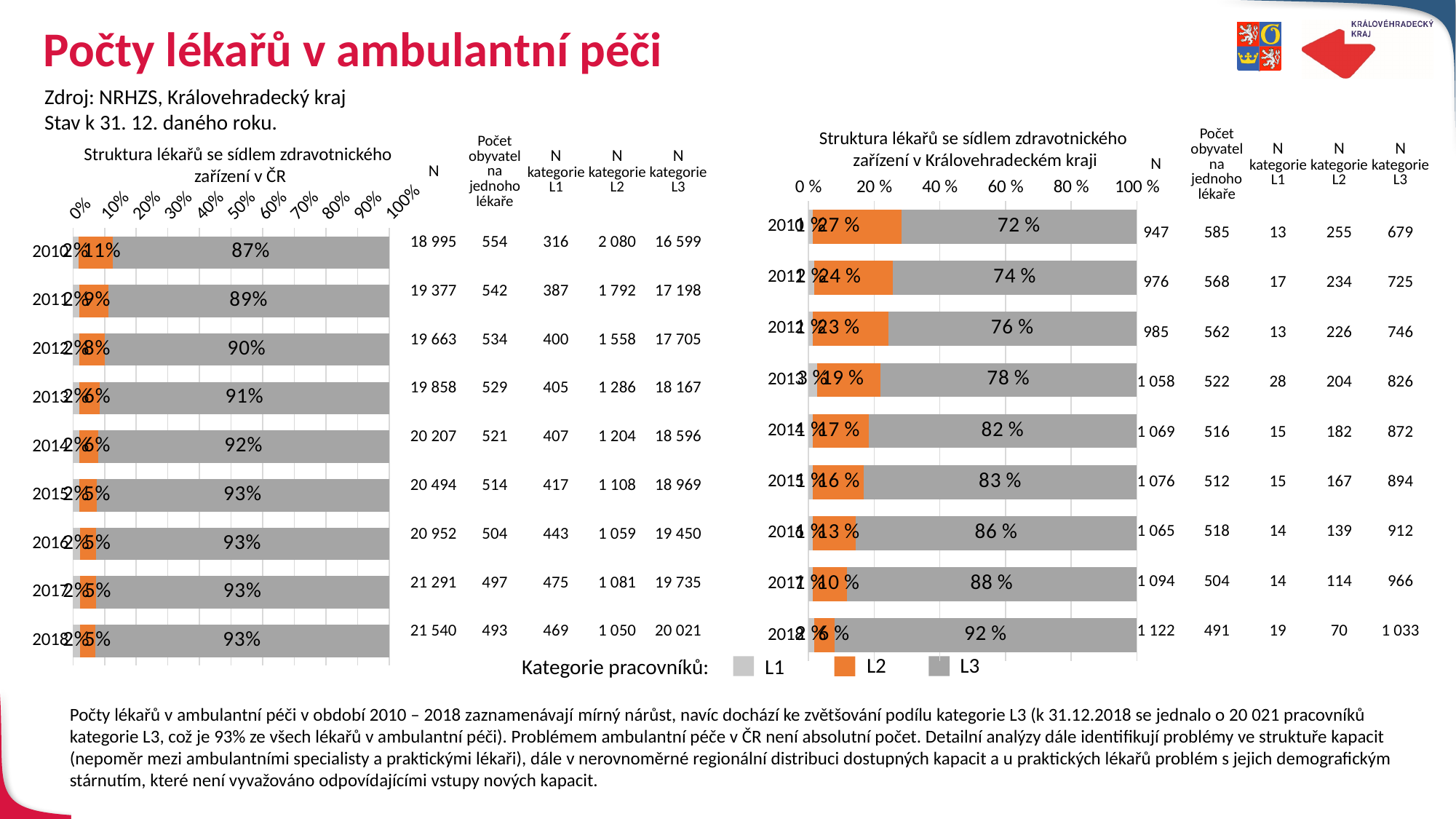
In the chart 'Struktura lékařů se sídlem zdravotnického zařízení v ČR', what is the L3 share for 2010? 87% In the chart 'Struktura lékařů se sídlem zdravotnického zařízení v Královehradeckém kraji', which year has the highest L3 share? 2018 In the chart 'Struktura lékařů se sídlem zdravotnického zařízení v ČR', is the L2 share larger in 2010 or in 2018? 2010 What type of chart is 'Struktura lékařů se sídlem zdravotnického zařízení v ČR'? Stacked bar chart In the chart 'Struktura lékařů se sídlem zdravotnického zařízení v ČR', which year has the lowest L3 share? 2010 In the chart 'Struktura lékařů se sídlem zdravotnického zařízení v Královehradeckém kraji', what is the L3 share for 2014? 82 % In the chart 'Struktura lékařů se sídlem zdravotnického zařízení v Královehradeckém kraji', does the L3 share rise or fall from 2010 to 2018? Rise In the chart 'Struktura lékařů se sídlem zdravotnického zařízení v Královehradeckém kraji', what is the L2 share for 2010? 27 % How many years are shown in the chart 'Struktura lékařů se sídlem zdravotnického zařízení v Královehradeckém kraji'? 9 How many categories of workers does the legend 'Kategorie pracovníků' list? 3 In the chart 'Struktura lékařů se sídlem zdravotnického zařízení v ČR', what is the L2 share for 2012? 8% In the chart 'Struktura lékařů se sídlem zdravotnického zařízení v Královehradeckém kraji', what is the difference between the L3 share in 2018 and in 2010? 20 %